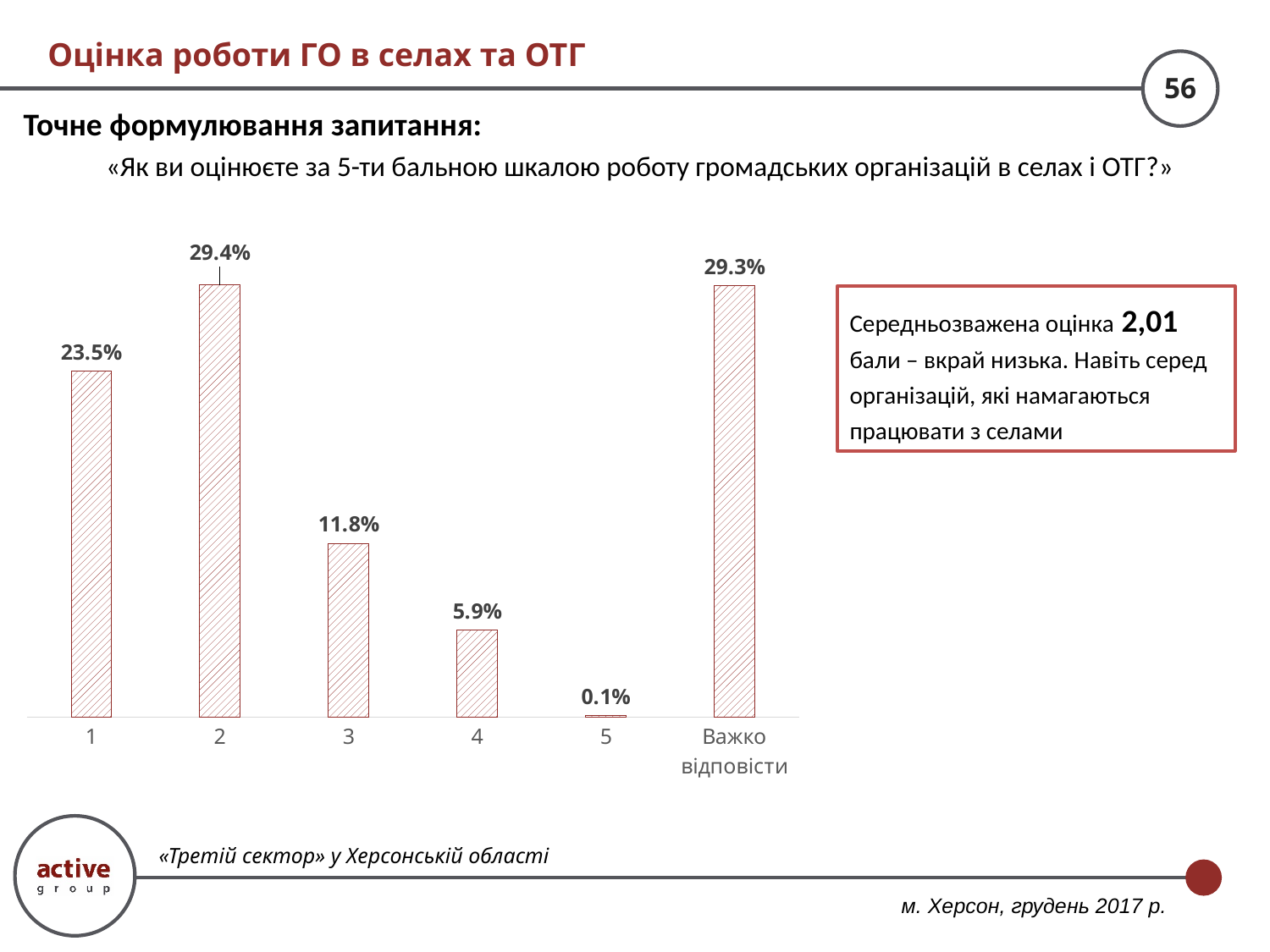
What is the value for the category "Важко відповісти"? 29.3% What kind of chart is shown on the slide? bar chart What percentage of respondents gave a rating of 2? 29.4% Which category has the lowest value? 5 What percentage of respondents gave a rating of 5? 0.1% What weighted average score is stated in the text box next to the chart? 2,01 What is the value for rating 1? 23.5% Do the values rise or fall from rating 2 to rating 5? fall What is the difference between the values for rating 2 and rating 4? 23.5% How many categories are shown on the x axis? 6 Which is larger, the value for rating 3 or the value for rating 4? rating 3 What is the difference between the values for rating 1 and rating 3? 11.7%